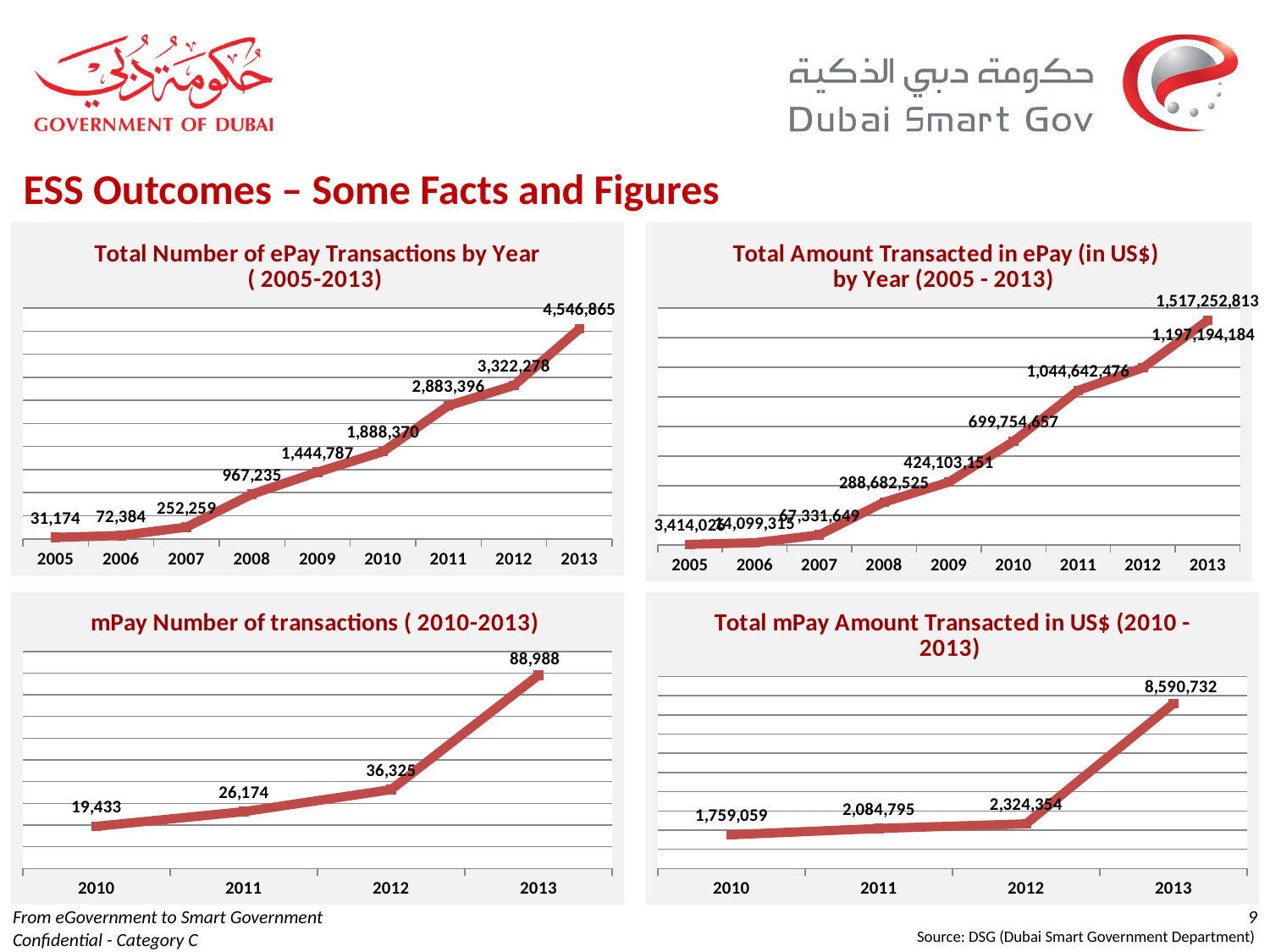
In the 'mPay Number of transactions (2010-2013)' chart, which year has the lowest value? 2010 In the 'Total Number of ePay Transactions by Year' chart, what is the value for 2013? 4,546,865 In the 'Total Number of ePay Transactions by Year' chart, what is the value for 2008? 967,235 What kind of chart is the 'Total mPay Amount Transacted in US$ (2010-2013)' chart? Line chart In the 'mPay Number of transactions (2010-2013)' chart, what is the value for 2011? 26,174 In the 'Total mPay Amount Transacted in US$ (2010-2013)' chart, what is the value for 2012? 2,324,354 In the 'Total mPay Amount Transacted in US$ (2010-2013)' chart, what is the difference between the 2013 and 2012 values? 6,266,378 How many years are plotted in the 'Total Number of ePay Transactions by Year' chart? 9 In the 'Total Amount Transacted in ePay (in US$) by Year' chart, which year has the highest value? 2013 In the 'mPay Number of transactions (2010-2013)' chart, what is the difference between the 2013 and 2012 values? 52,663 In the 'Total Number of ePay Transactions by Year' chart, do the values rise or fall from 2005 to 2013? Rise In the 'Total Amount Transacted in ePay (in US$) by Year' chart, what is the value for 2011? 1,044,642,476